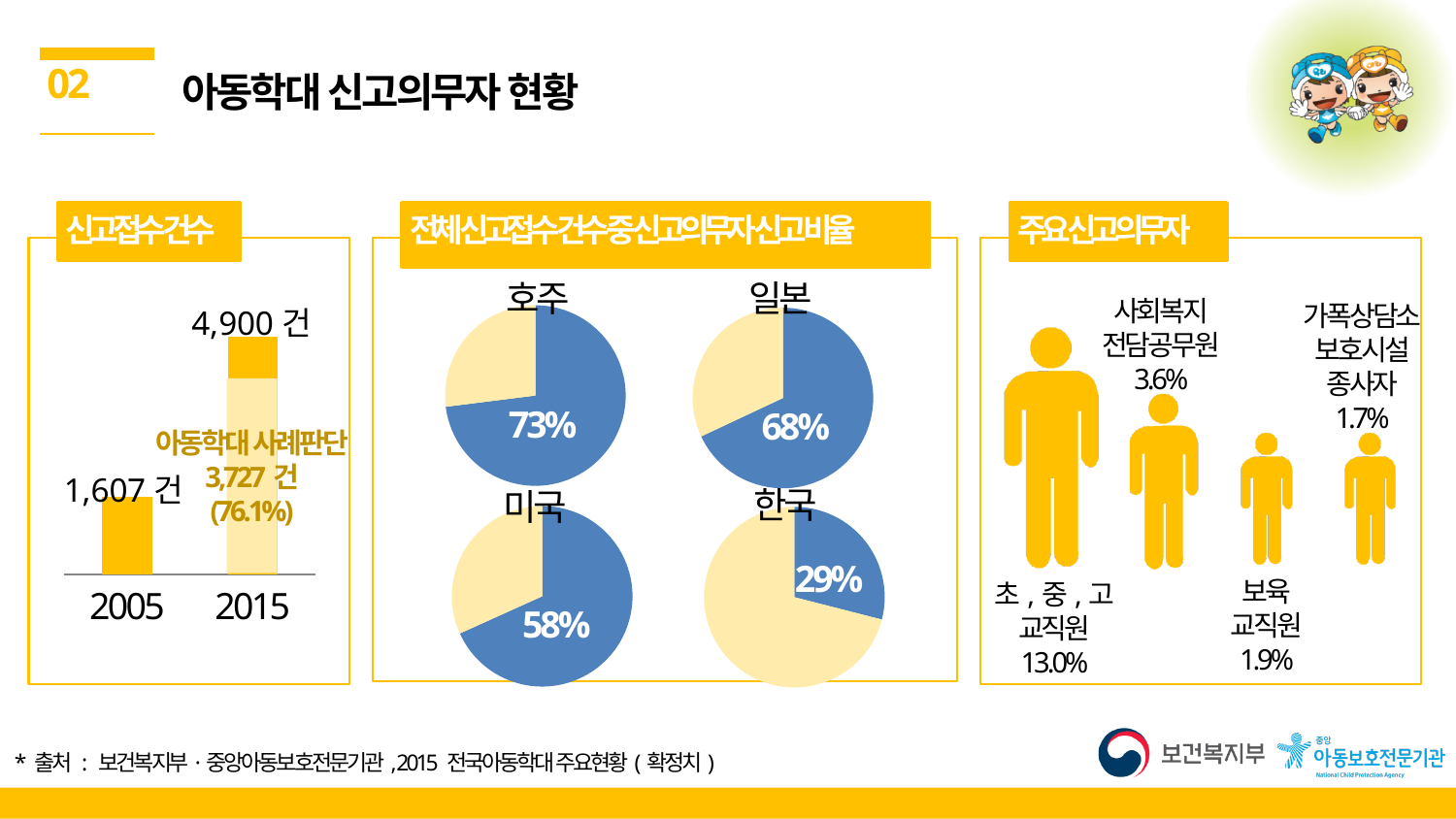
In the 전체신고접수건수중신고의무자신고비율 panel, what percentage is shown for 호주? 73% In the 신고접수건수 bar chart, what is the 아동학대 사례판단 value shown for 2015? 3,727 건 (76.1%) In the 신고접수건수 bar chart, what is the difference between the 2015 and 2005 values? 3,293 건 In the 전체신고접수건수중신고의무자신고비율 panel, which country has the lowest percentage? 한국 In the 전체신고접수건수중신고의무자신고비율 panel, what percentage is shown for 한국? 29% In the 주요신고의무자 panel, which group has the lowest percentage? 가폭상담소 보호시설 종사자 In the 신고접수건수 bar chart, what is the value for 2005? 1,607 건 What kind of chart is the 신고접수건수 chart? bar chart In the 전체신고접수건수중신고의무자신고비율 panel, which is larger, the percentage for 일본 or for 미국? 일본 In the 주요신고의무자 panel, what percentage is shown for 초, 중, 고 교직원? 13.0% In the 신고접수건수 bar chart, what is the value for 2015? 4,900 건 How many pie charts are in the 전체신고접수건수중신고의무자신고비율 panel? 4